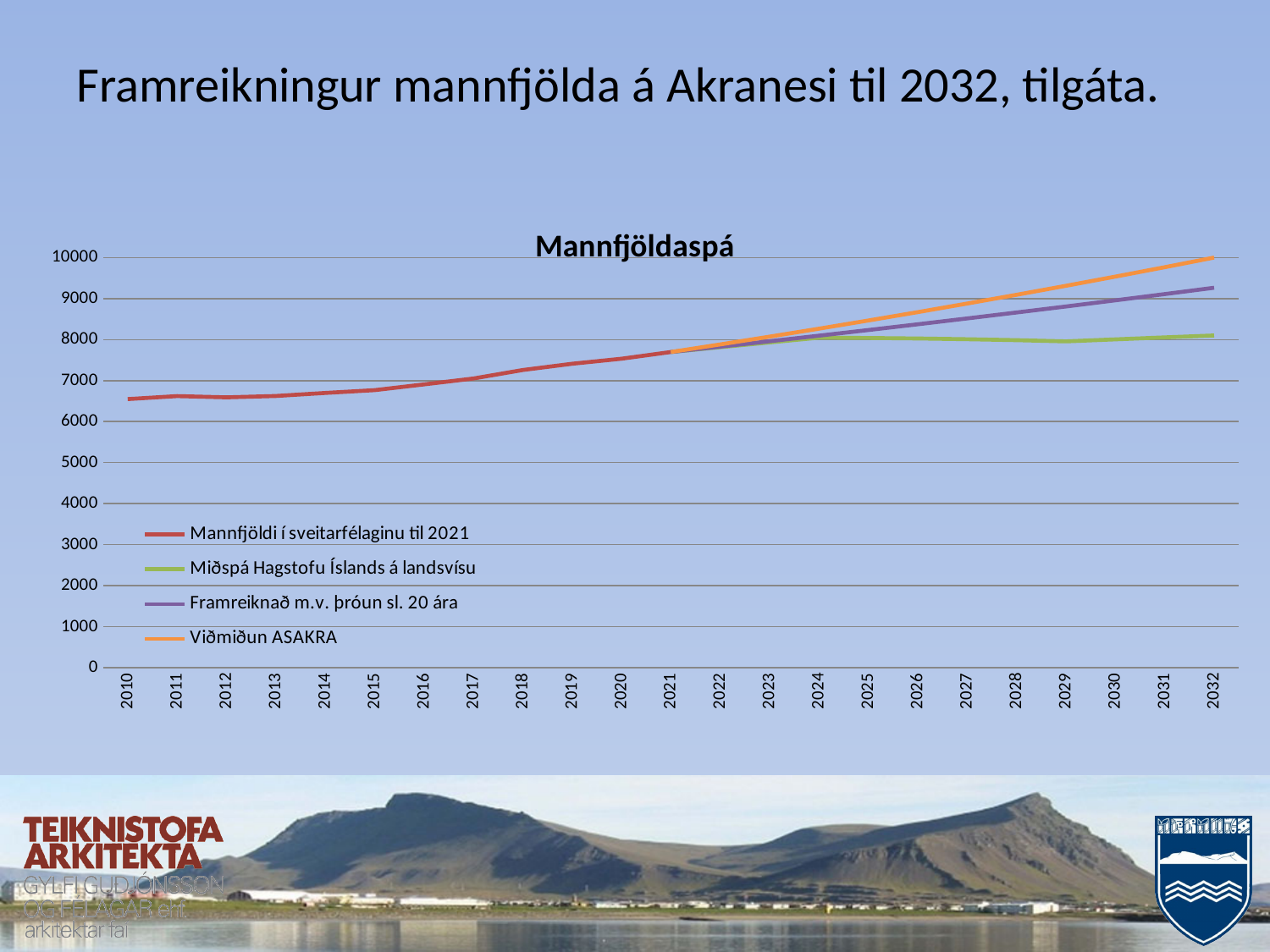
Does the Mannfjöldi í sveitarfélaginu til 2021 series rise or fall from 2010 to 2021? rise Which series has the highest value in 2032? Viðmiðun ASAKRA How many series does the legend of the Mannfjöldaspá chart list? 4 Is the value for Mannfjöldi í sveitarfélaginu til 2021 in 2010 greater or less than 7000? less What is the title of the chart? Mannfjöldaspá Is the value for Framreiknað m.v. þróun sl. 20 ára in 2032 greater or less than 9000? greater Which series has the lowest value in 2032? Miðspá Hagstofu Íslands á landsvísu Is the value for Miðspá Hagstofu Íslands á landsvísu in 2032 greater or less than 9000? less What kind of chart is shown on the slide? line chart How many years are shown along the x axis of the Mannfjöldaspá chart? 23 In 2032, which is larger: Viðmiðun ASAKRA or Miðspá Hagstofu Íslands á landsvísu? Viðmiðun ASAKRA Which series is drawn in orange in the Mannfjöldaspá chart? Viðmiðun ASAKRA